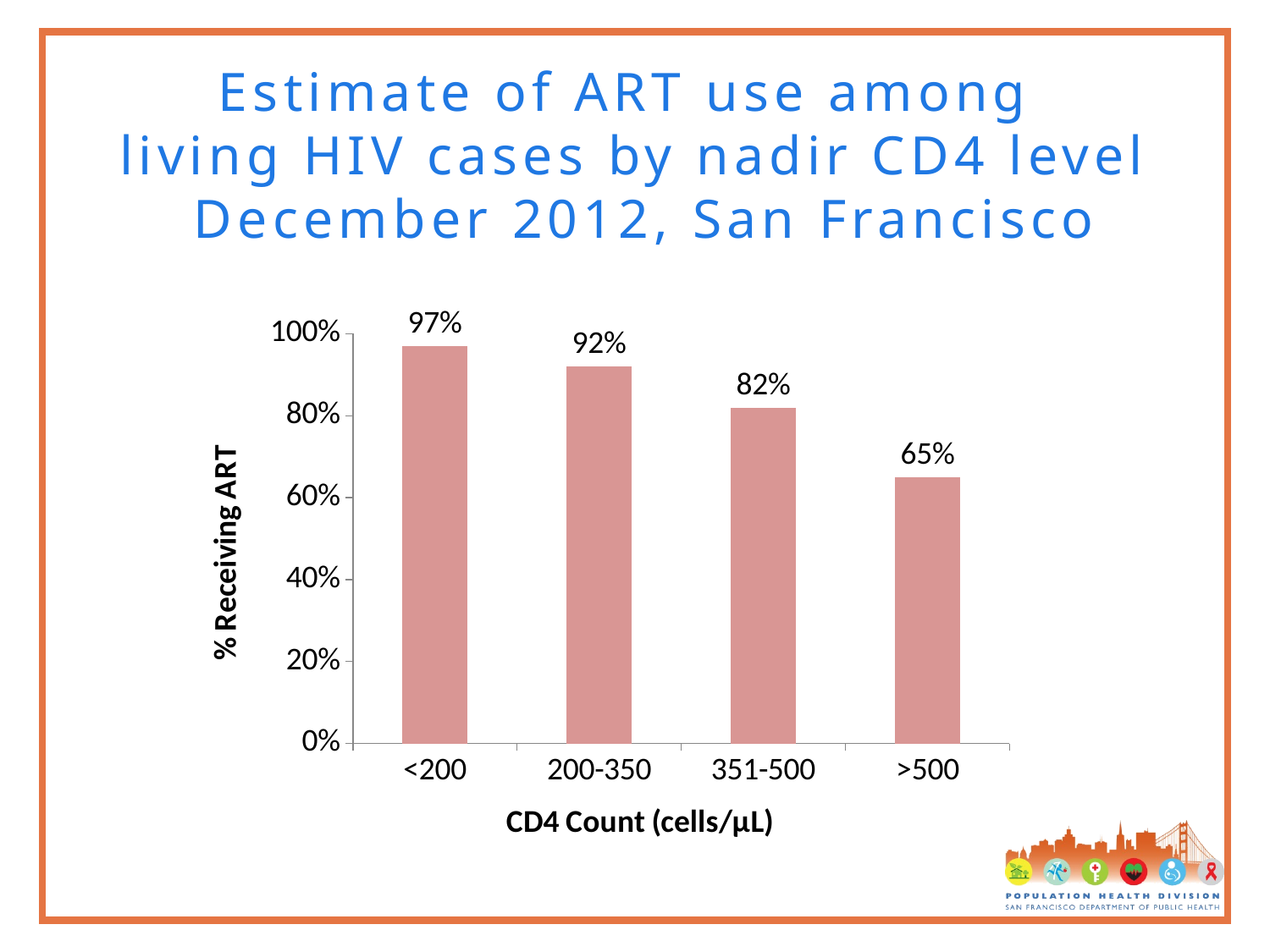
How many CD4 count categories are shown on the chart? 4 Which CD4 count category has the highest percentage receiving ART? <200 What percentage of living HIV cases with a nadir CD4 count of <200 are receiving ART? 97% What is the difference in percentage receiving ART between the <200 and >500 CD4 count groups? 32% What is the value for the >500 CD4 count category? 65% What is the value for the 200-350 CD4 count category? 92% What kind of chart is shown on the slide? Bar chart Do the values rise or fall as the CD4 count categories increase along the x axis? Fall Which has a higher percentage receiving ART: the 200-350 group or the 351-500 group? 200-350 Which CD4 count category has the lowest percentage receiving ART? >500 What percentage receiving ART is shown for the 351-500 CD4 count group? 82% Is the value for the >500 CD4 count group greater or less than 80%? less